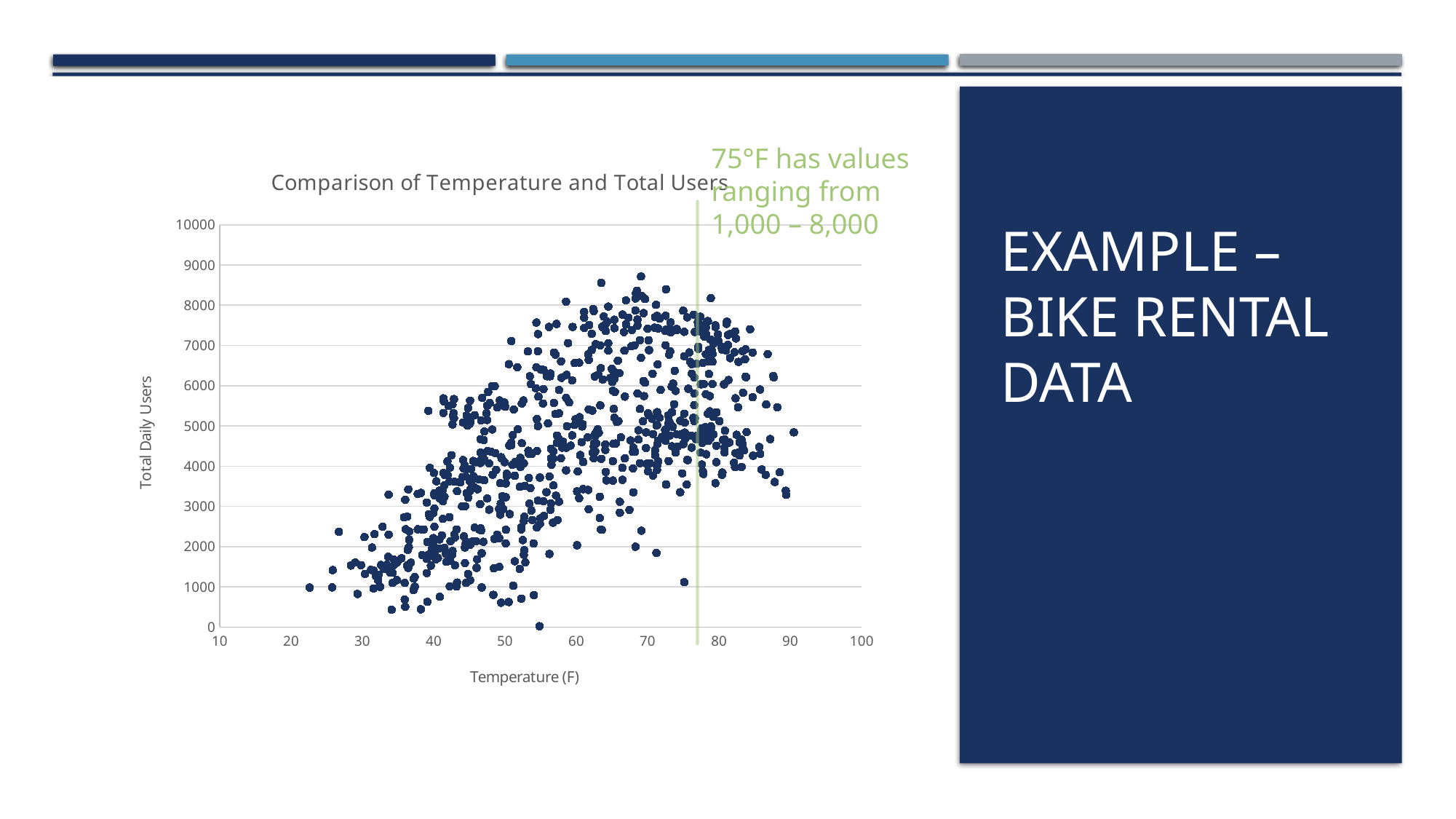
Is the highest plotted value of total daily users greater or less than 9000? less Is the highest plotted value of total daily users greater or less than 8000? greater What is the title of the chart? Comparison of Temperature and Total Users Do total daily users generally rise or fall as temperature increases from 20 to 70 on the x axis? Rise According to the green annotation, what range of values does 75°F have? 1,000 – 8,000 Is the highest temperature plotted greater or less than 80? greater What kind of chart is shown on the slide? Scatter chart What is the maximum value shown on the y axis? 10000